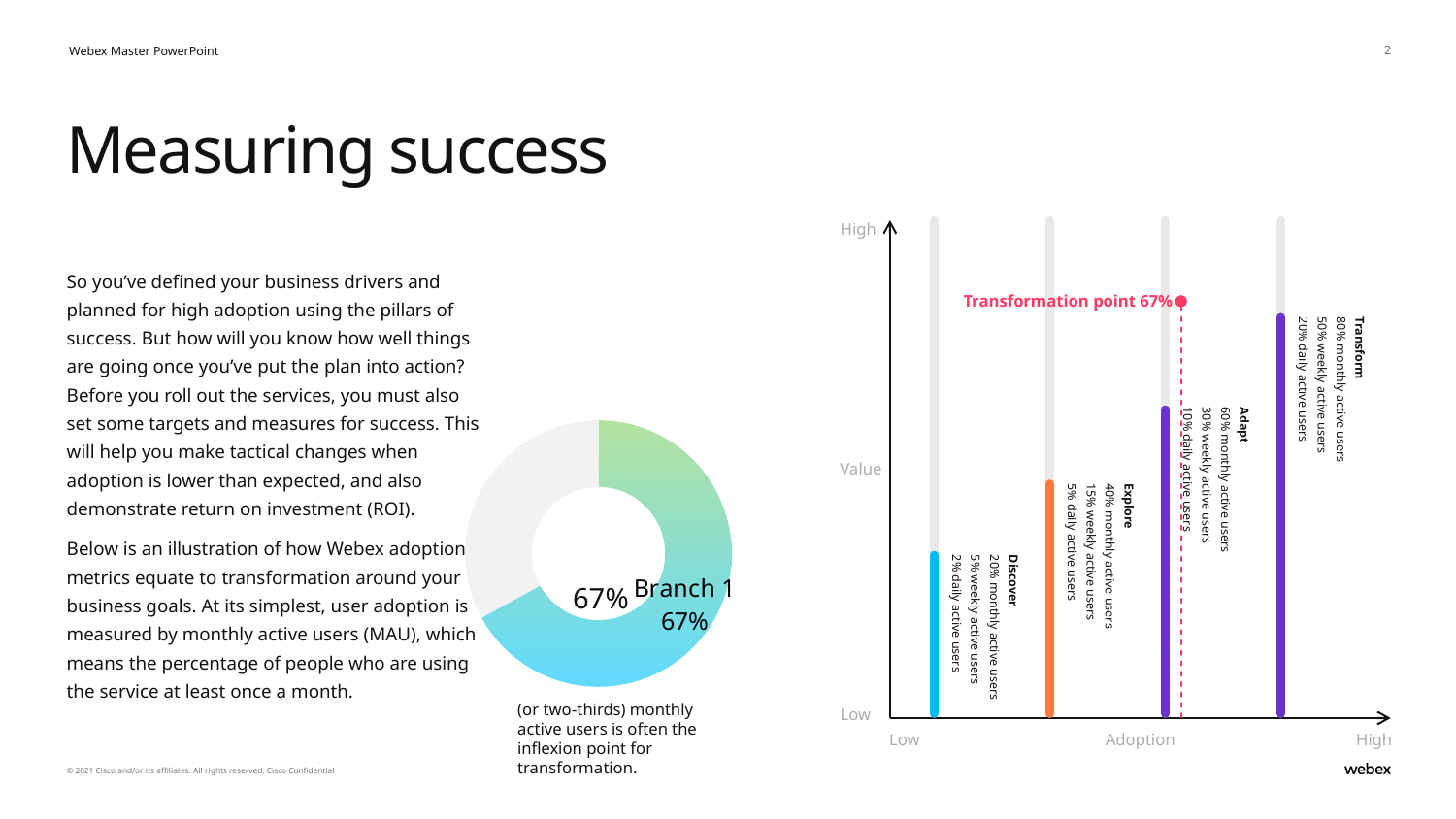
In the bar chart on the right, how many stages (bars) are shown along the Adoption axis? 4 What kind of chart is the chart on the right of the slide? bar chart In the bar chart on the right, which stage has the shortest bar? Discover In the bar chart on the right, what percentage of monthly active users is listed for the Explore stage? 40% In the bar chart on the right, what percentage is given for the Transformation point? 67% In the donut chart on the left, is the Branch 1 value greater or less than 50%? greater In the bar chart on the right, which stage has the tallest bar? Transform What kind of chart is the chart on the left of the slide? pie chart (donut) In the donut chart on the left, what share of the pie does the coloured Branch 1 slice represent? 67% In the bar chart on the right, what is the label on the horizontal axis? Adoption In the donut chart on the left, what percentage is shown for Branch 1? 67% In the bar chart on the right, do the bar heights rise or fall from left to right along the Adoption axis? rise